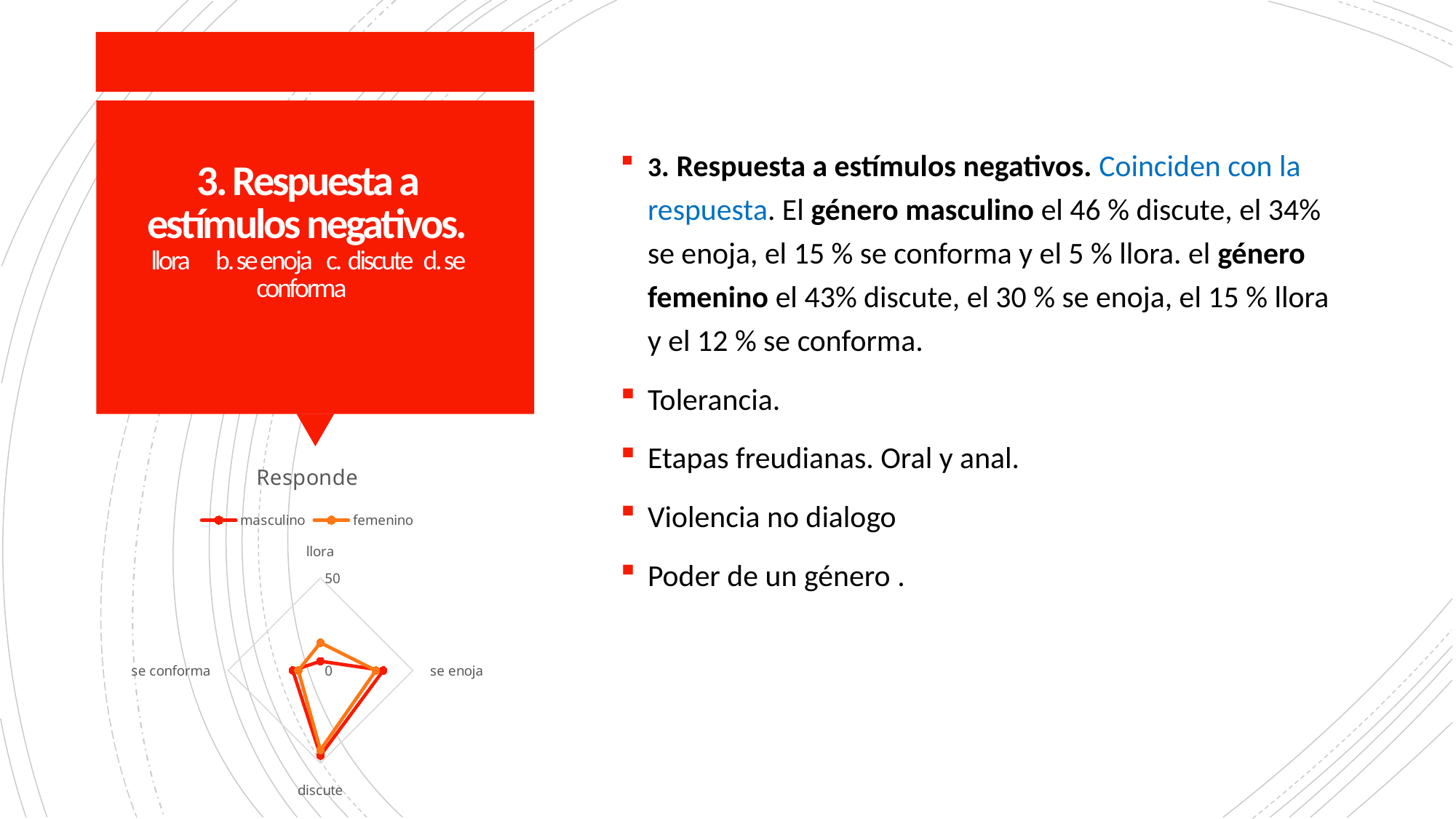
Which two series are listed in the chart legend? masculino and femenino Which category has the lowest value for the masculino series? llora For the category llora, which series has the larger value: masculino or femenino? femenino Which category has the highest value for the femenino series? discute How many series does the chart legend list? 2 Which category has the highest value for the masculino series? discute Is the value for se enoja in the masculino series greater or less than 50? less How many categories are plotted on the radar chart? 4 For the masculino series, which is larger: discute or se enoja? discute Is the value for llora in the femenino series greater or less than 50? less What is the title of the chart on the slide? Responde What kind of chart is shown on the slide? Radar chart